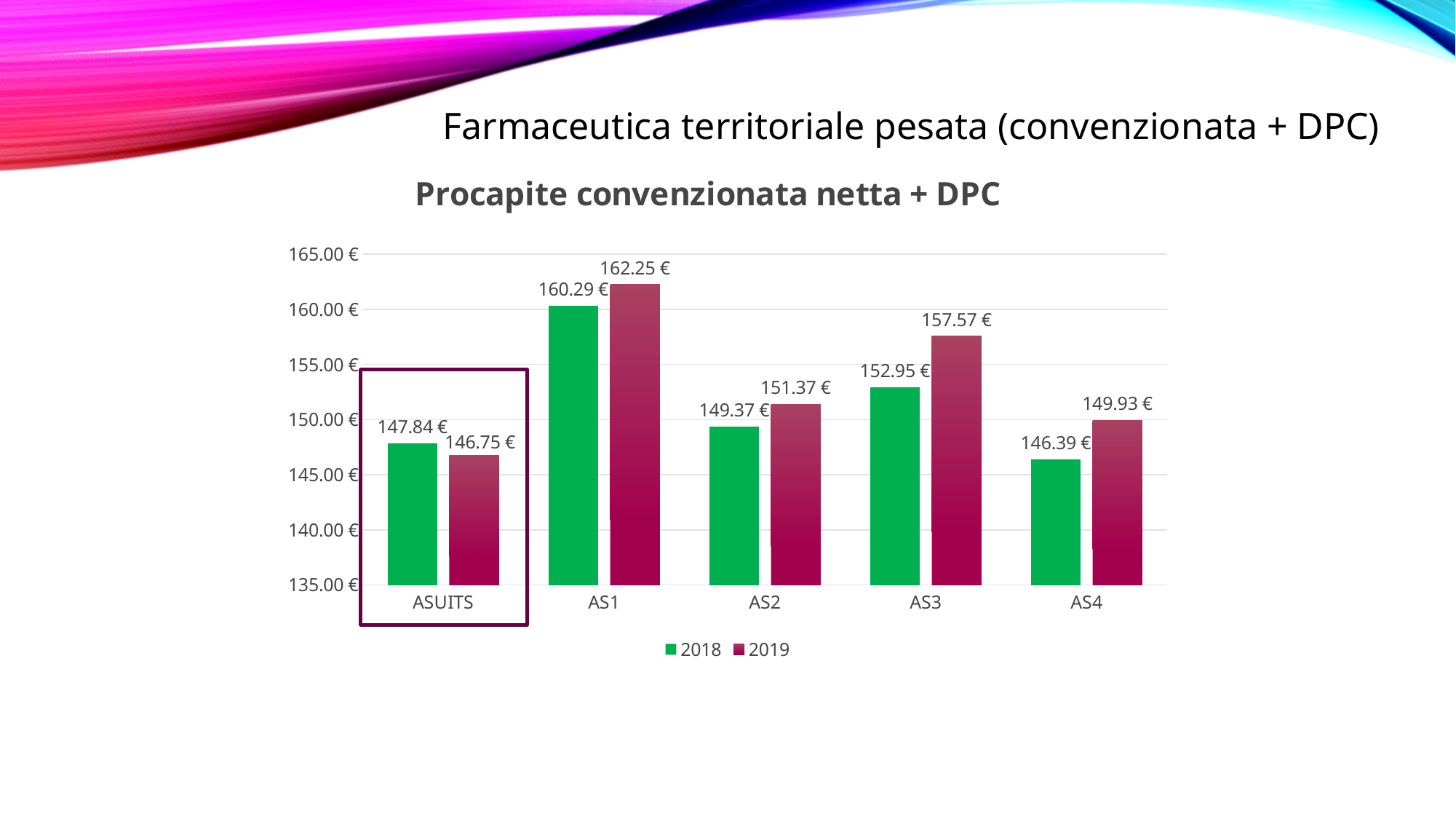
Is the 2018 value for AS2 greater or less than 150.00 €? less What is the title of the chart? Procapite convenzionata netta + DPC How many series does the legend list? 2 Which is larger for ASUITS, the 2018 value or the 2019 value? 2018 What is the 2018 value for ASUITS? 147.84 € Which category has the lowest 2018 value? AS4 What is the difference between the 2019 and 2018 values for AS3? 4.62 € What is the 2019 value for AS4? 149.93 € How many categories are shown on the x axis? 5 Which category has the highest 2019 value? AS1 What kind of chart is shown? bar chart What is the 2019 value for AS1? 162.25 €